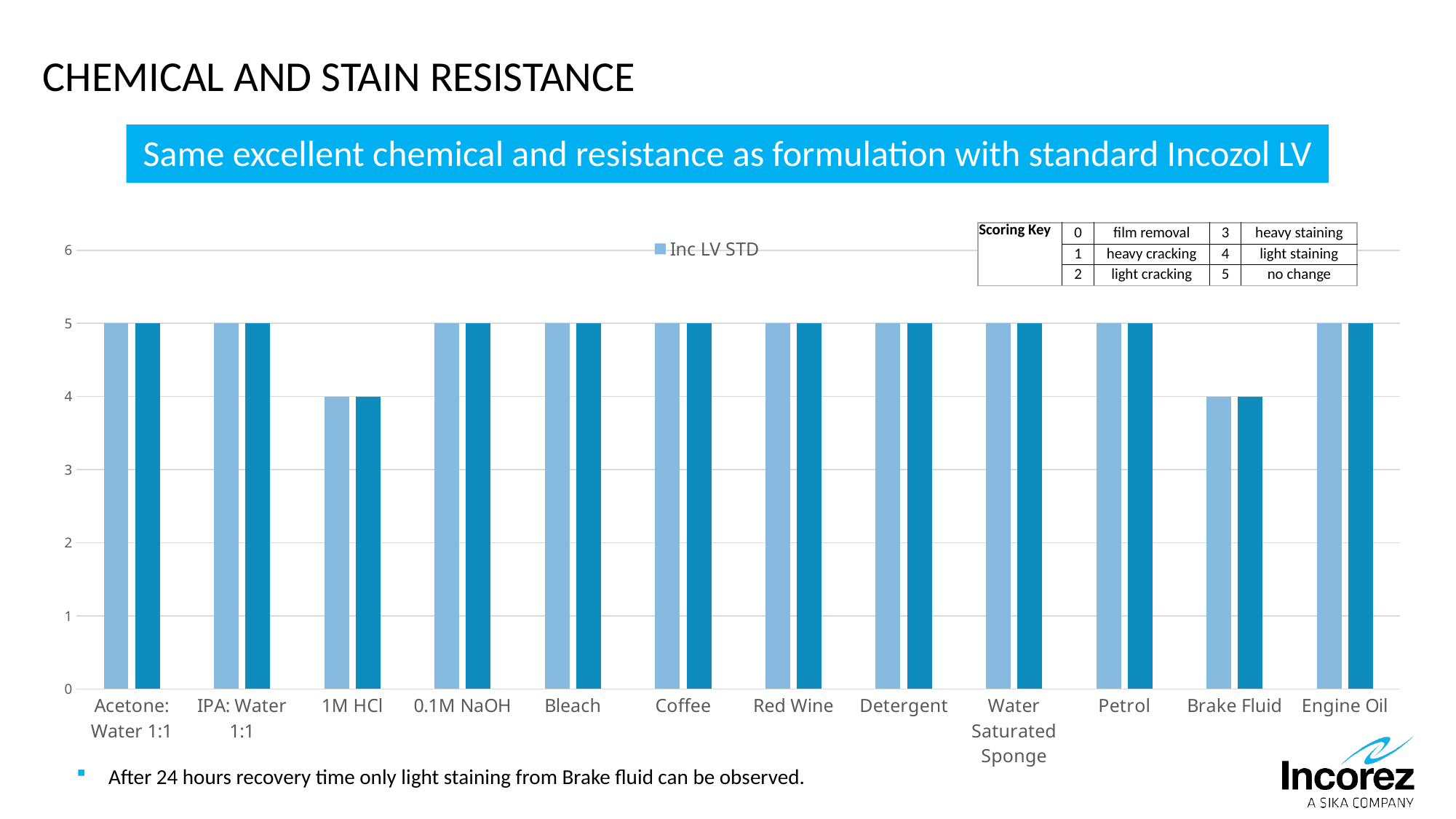
What score is shown for 1M HCl? 4 What score is shown for Water Saturated Sponge? 5 Which has the higher score, Petrol or Brake Fluid? Petrol What entry does the chart legend list? Inc LV STD What kind of chart is shown on the slide? bar chart Is the score for Engine Oil greater or less than 4? greater How many categories are shown along the x axis of the chart? 12 What score is shown for Brake Fluid? 4 What is the difference between the score for Bleach and the score for 1M HCl? 1 Which two categories have the lowest score in the chart? 1M HCl and Brake Fluid What score is shown for Coffee? 5 According to the scoring key on the slide, what does a score of 5 mean? no change